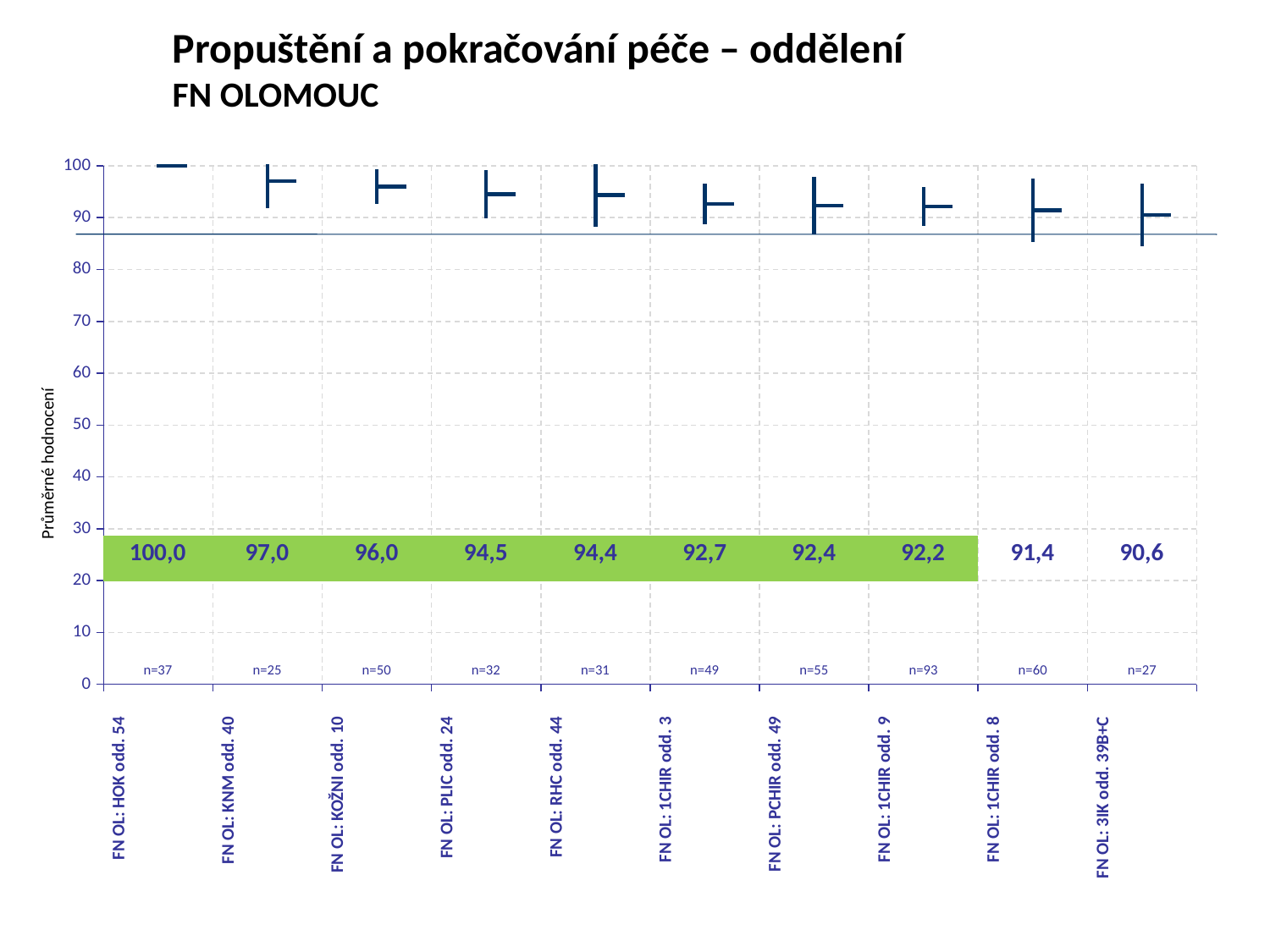
Do the average ratings rise or fall from left to right along the x axis? fall Which has a higher average rating: FN OL: RHC odd. 44 or FN OL: PCHIR odd. 49? FN OL: RHC odd. 44 How many departments are shown on the chart? 10 What is the average rating for FN OL: PLIC odd. 24? 94,5 What is the sample size (n) shown for FN OL: 1CHIR odd. 9? n=93 What is the difference between the average ratings of FN OL: KNM odd. 40 and FN OL: KOŽNI odd. 10? 1,0 Which department has the highest average rating? FN OL: HOK odd. 54 Which department has the lowest average rating? FN OL: 3IK odd. 39B+C Is the average rating for FN OL: 1CHIR odd. 8 greater or less than 80? greater What is the label of the vertical axis? Průměrné hodnocení What is the average rating for FN OL: 3IK odd. 39B+C? 90,6 What is the average rating (průměrné hodnocení) for FN OL: HOK odd. 54? 100,0